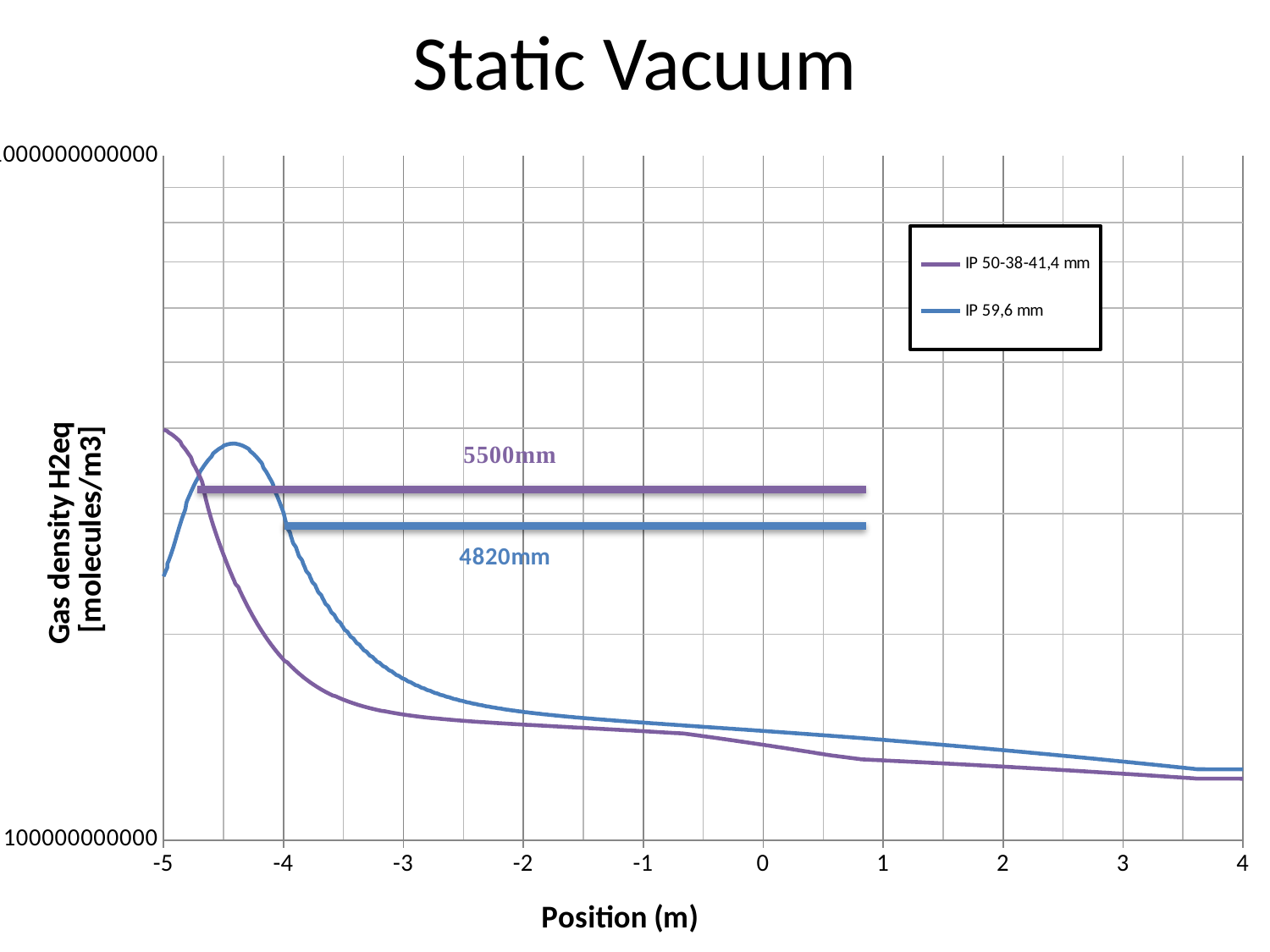
What kind of chart is shown on the slide? Line chart At position -3 m, which series has the higher gas density, IP 50-38-41,4 mm or IP 59,6 mm? IP 59,6 mm What is the label of the x axis? Position (m) What length is annotated next to the purple horizontal bar? 5500mm Which series is drawn in purple? IP 50-38-41,4 mm At position -5 m, which series has the higher gas density, IP 50-38-41,4 mm or IP 59,6 mm? IP 50-38-41,4 mm Between position -4.5 m and 4 m, does the gas density for IP 50-38-41,4 mm rise or fall? Fall How many series does the legend list? 2 Between position -4 m and 4 m, does the gas density for IP 59,6 mm rise or fall? Fall